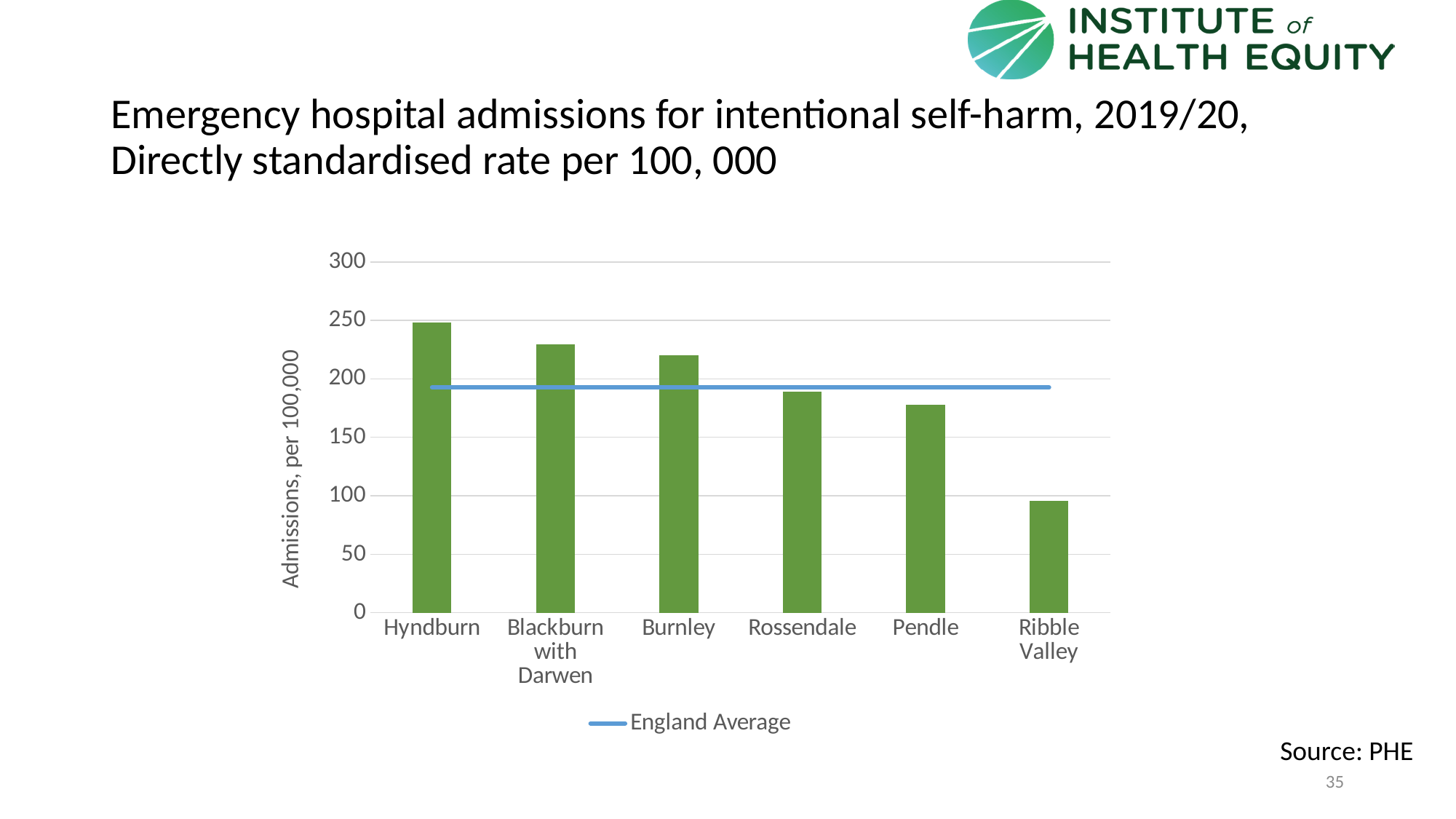
Is the value for Ribble Valley greater or less than 100? less Which area has the lowest emergency hospital admission rate for intentional self-harm? Ribble Valley Which area has the highest emergency hospital admission rate for intentional self-harm? Hyndburn Which is larger, the value for Pendle or the value for Ribble Valley? Pendle Is the value for Pendle greater or less than 200? less Is the value for Burnley greater or less than 200? greater How many series does the legend list? 1 Which is larger, the value for Blackburn with Darwen or the value for Rossendale? Blackburn with Darwen How many areas are shown on the x axis of the chart? 6 What kind of chart is used to show the admission rates by area? Bar chart Do the bar values rise or fall from left to right along the x axis? Fall